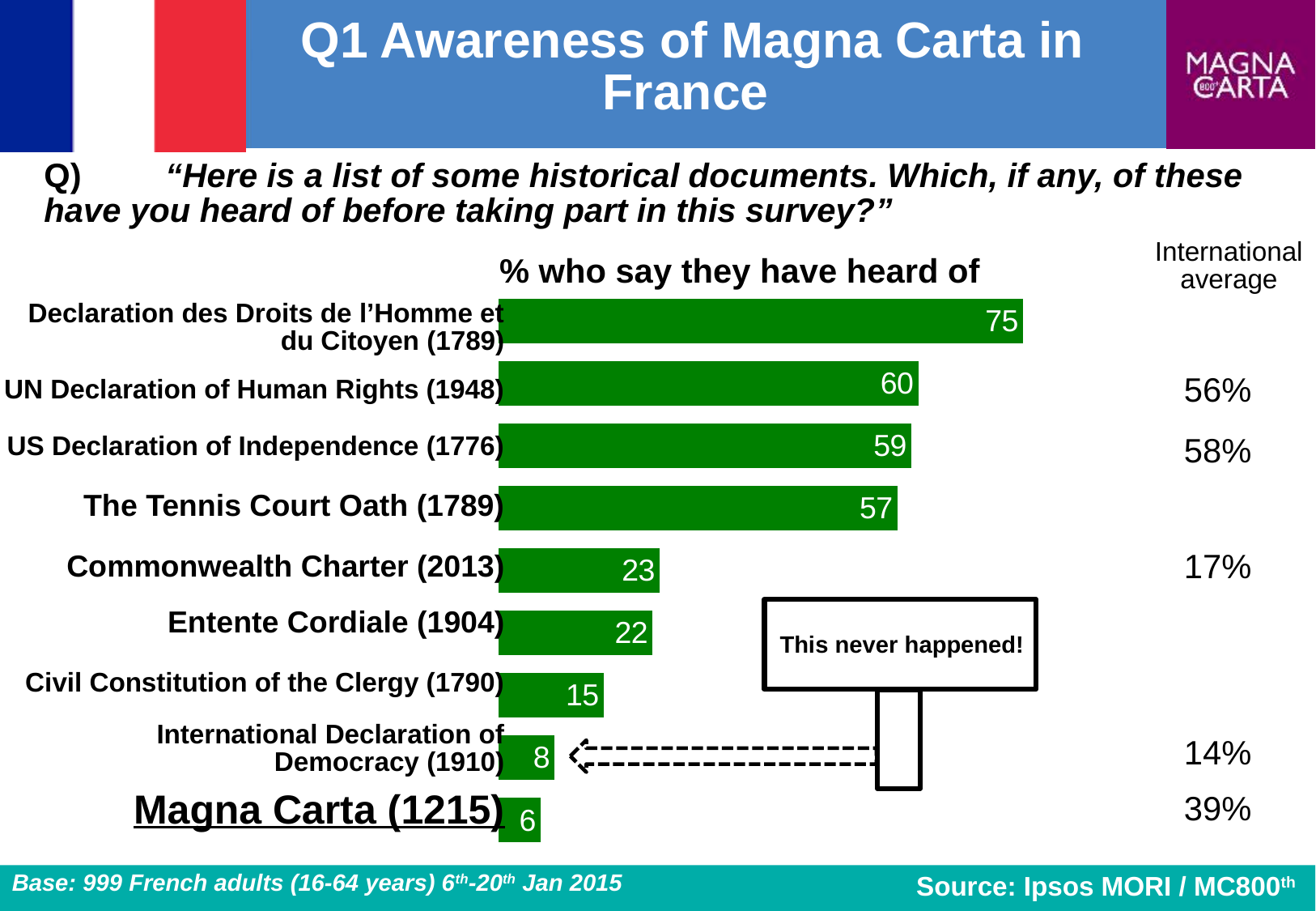
How many historical documents are shown as bars in the chart? 9 What is the difference between the values for the UN Declaration of Human Rights (1948) and Magna Carta (1215)? 54 Which historical document has the highest awareness in the chart? Declaration des Droits de l'Homme et du Citoyen (1789) Which has a higher value: the Civil Constitution of the Clergy (1790) or the International Declaration of Democracy (1910)? Civil Constitution of the Clergy (1790) What value is shown for The Tennis Court Oath (1789)? 57 What type of chart is used on this slide? Bar chart What percentage of French adults say they have heard of the Declaration des Droits de l'Homme et du Citoyen (1789)? 75 What value is shown for Magna Carta (1215) in the chart? 6 Which historical document has the lowest awareness in the chart? Magna Carta (1215) What is the value shown for the US Declaration of Independence (1776)? 59 What is the difference between the values for the Commonwealth Charter (2013) and the Entente Cordiale (1904)? 1 What is the heading printed above the bars in the chart? % who say they have heard of